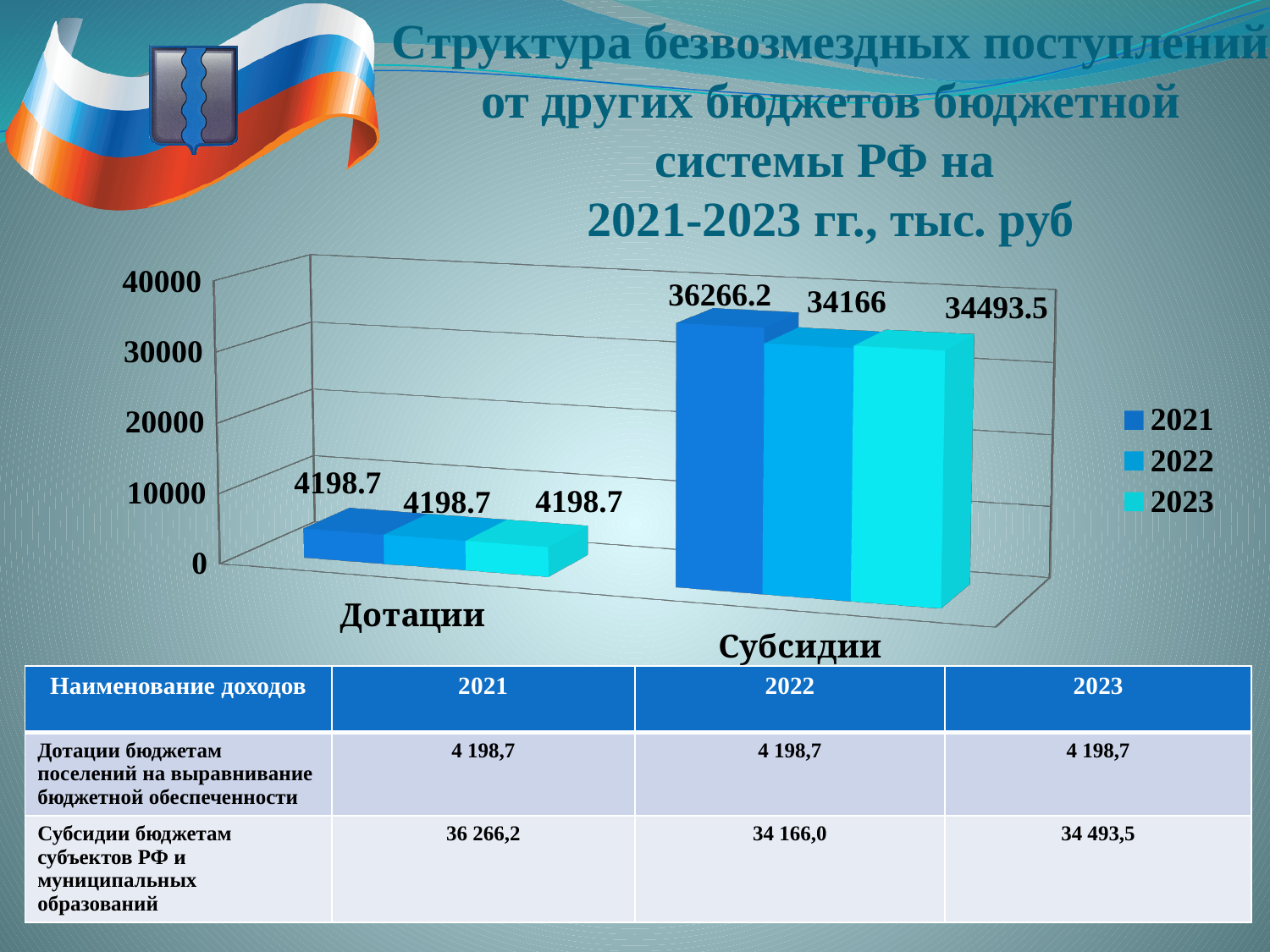
How many series does the legend list? 3 What is the value for Субсидии in 2022? 34166 What is the value for Субсидии in 2023? 34493.5 Which year has the highest value for Субсидии? 2021 What is the value for Субсидии in 2021? 36266.2 Which year has the lowest value for Субсидии? 2022 Which is larger: Субсидии in 2023 or Субсидии in 2022? Субсидии in 2023 What kind of chart is shown on the slide? bar chart Is the value for Субсидии in 2021 greater or less than 30000? greater What is the value for Дотации in 2021? 4198.7 What is the difference between the Субсидии values for 2021 and 2022? 2100.2 How many categories are shown on the x axis? 2